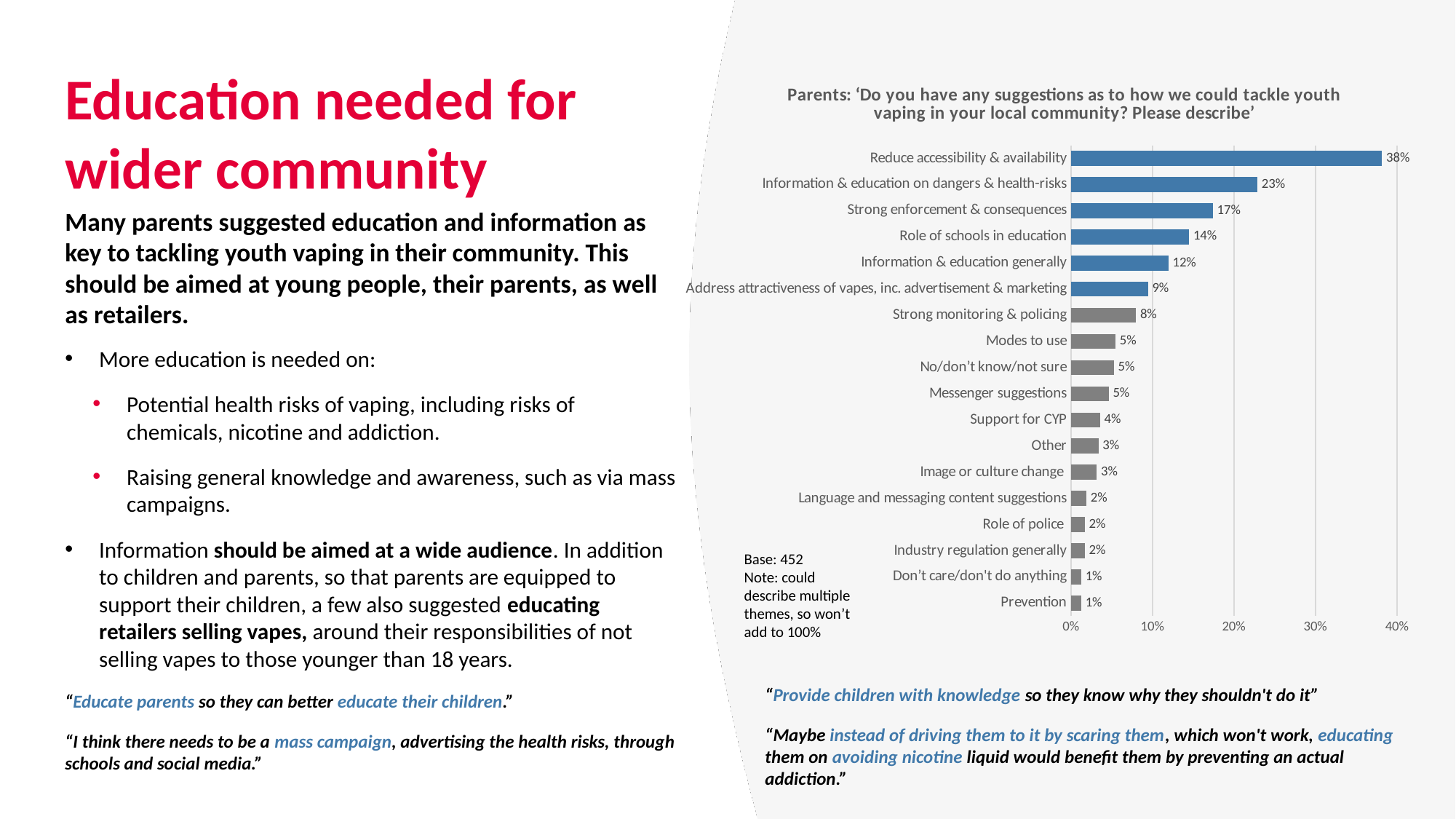
What is the value for 'Role of schools in education'? 14% What is the value for 'Support for CYP'? 4% Is the value for 'Address attractiveness of vapes, inc. advertisement & marketing' greater or less than 10%? less Which is larger: 'Strong enforcement & consequences' or 'Information & education generally'? Strong enforcement & consequences How many categories are shown on the chart? 18 What percentage of parents suggested 'Reduce accessibility & availability'? 38% Which suggestion has the highest percentage? Reduce accessibility & availability What is the base (number of respondents) noted for the chart? 452 What is the lowest percentage shown on the chart? 1% What type of chart is shown on the slide? Bar chart What is the difference between 'Reduce accessibility & availability' and 'Information & education on dangers & health-risks'? 15 percentage points What percentage is shown for 'Strong monitoring & policing'? 8%